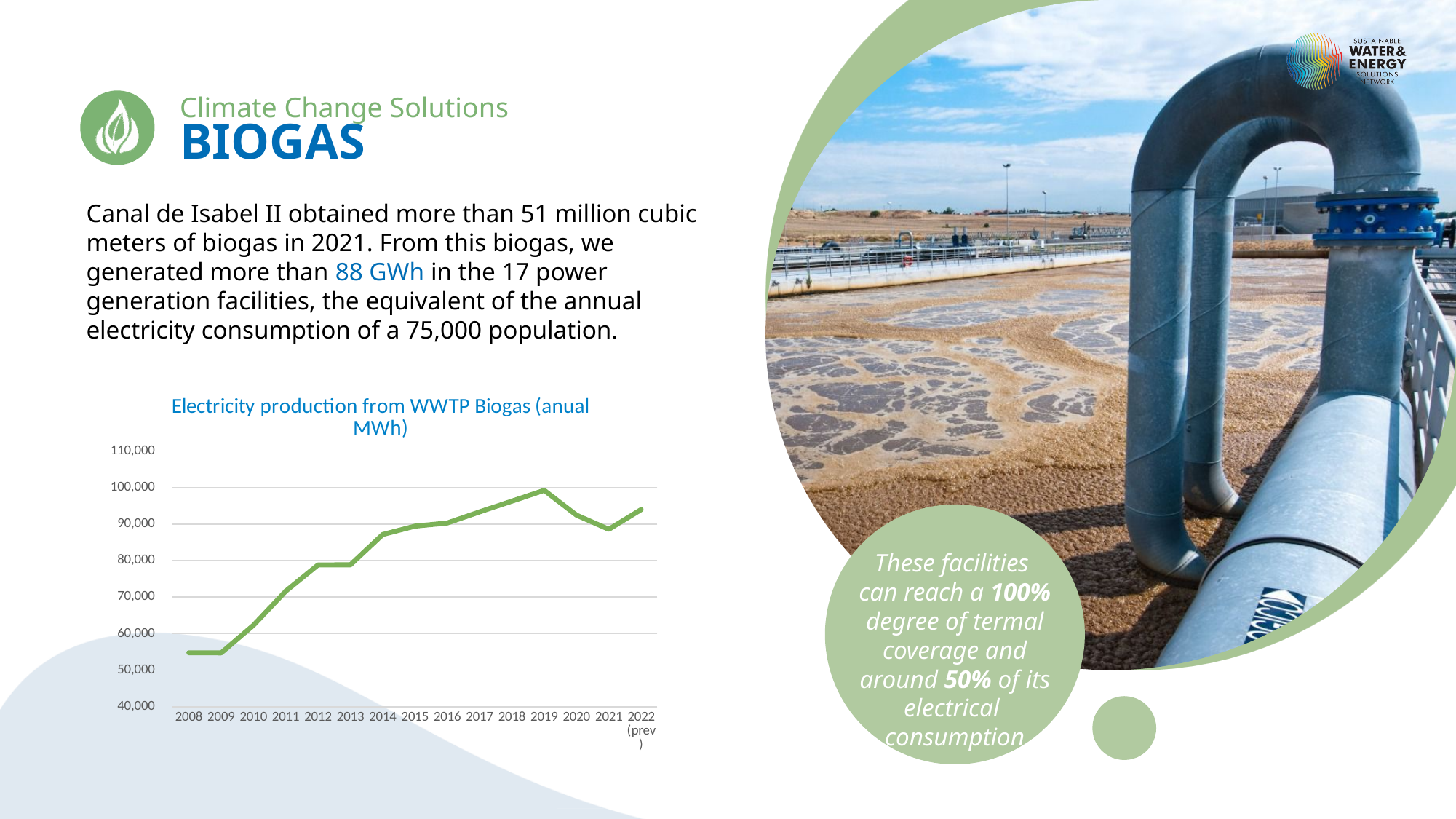
What kind of chart is shown on the slide? line chart Which year has the larger value, 2019 or 2021? 2019 Which year has the larger value, 2008 or 2018? 2018 What is the lowest value shown on the chart's y axis? 40,000 Is the value for 2008 greater or less than 60,000? less Which year has the highest electricity production in the chart? 2019 What is the title of the chart? Electricity production from WWTP Biogas (anual MWh) How many years (data points) are plotted on the x axis of the chart? 15 Is the value for 2010 greater or less than 60,000? greater Is the value for 2014 greater or less than 80,000? greater Does electricity production generally rise or fall from 2008 to 2019? rise